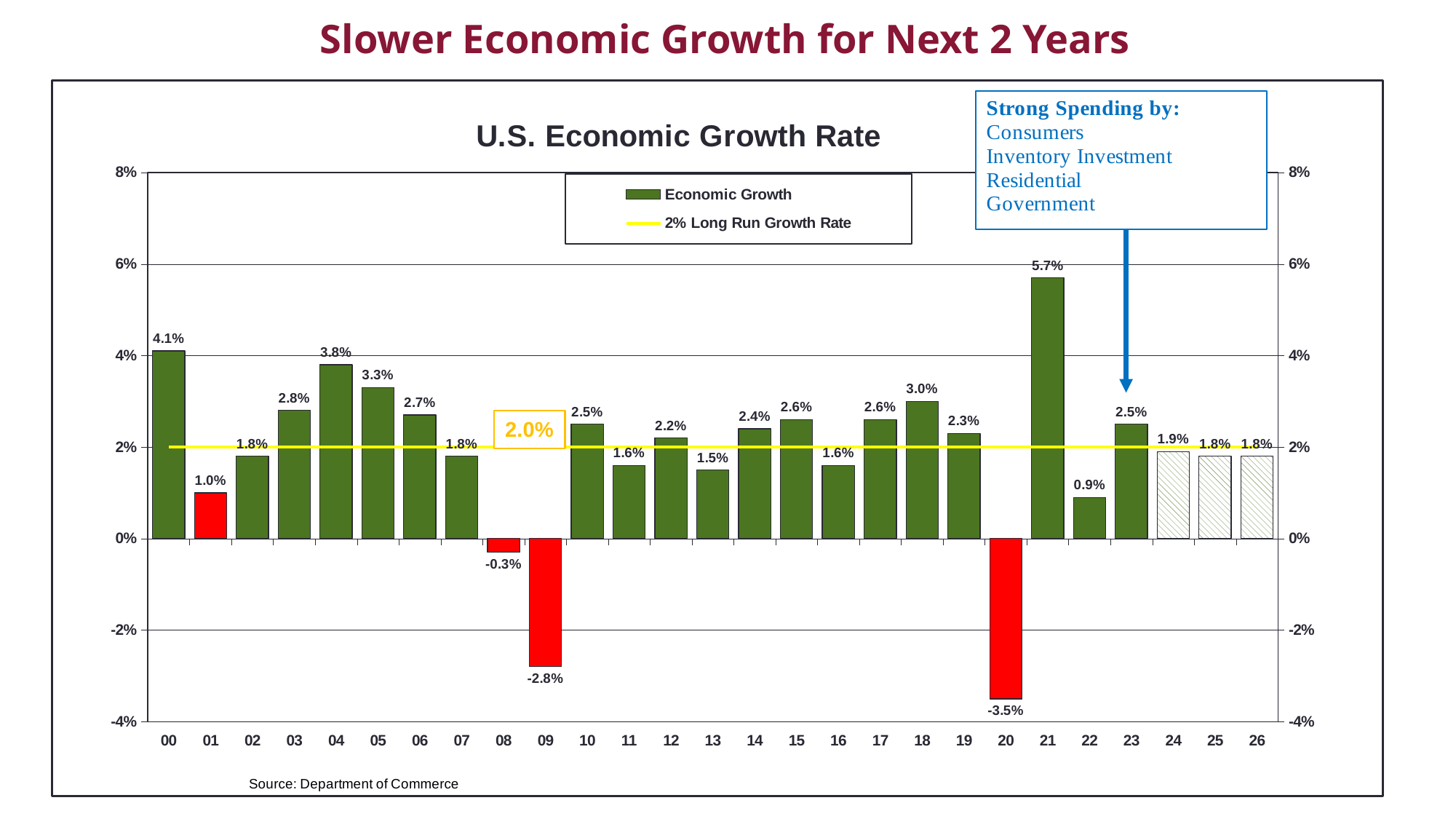
What is the economic growth rate shown for 2024? 1.9% What is the value of the long run growth rate line shown on the chart? 2.0% What is the difference between the growth rate in 2021 and the growth rate in 2022? 4.8% Which year has the highest economic growth rate on the chart? 21 What is the economic growth rate shown for 2009? -2.8% What kind of chart is used to show the U.S. Economic Growth Rate? Bar chart What is the economic growth rate shown for 2021? 5.7% How many years are shown on the x axis of the chart? 27 How many entries does the legend list? 2 Do the growth rates rise or fall from 2023 to 2026? Fall Which year had a higher growth rate, 2004 or 2005? 04 Which year has the lowest economic growth rate on the chart? 20